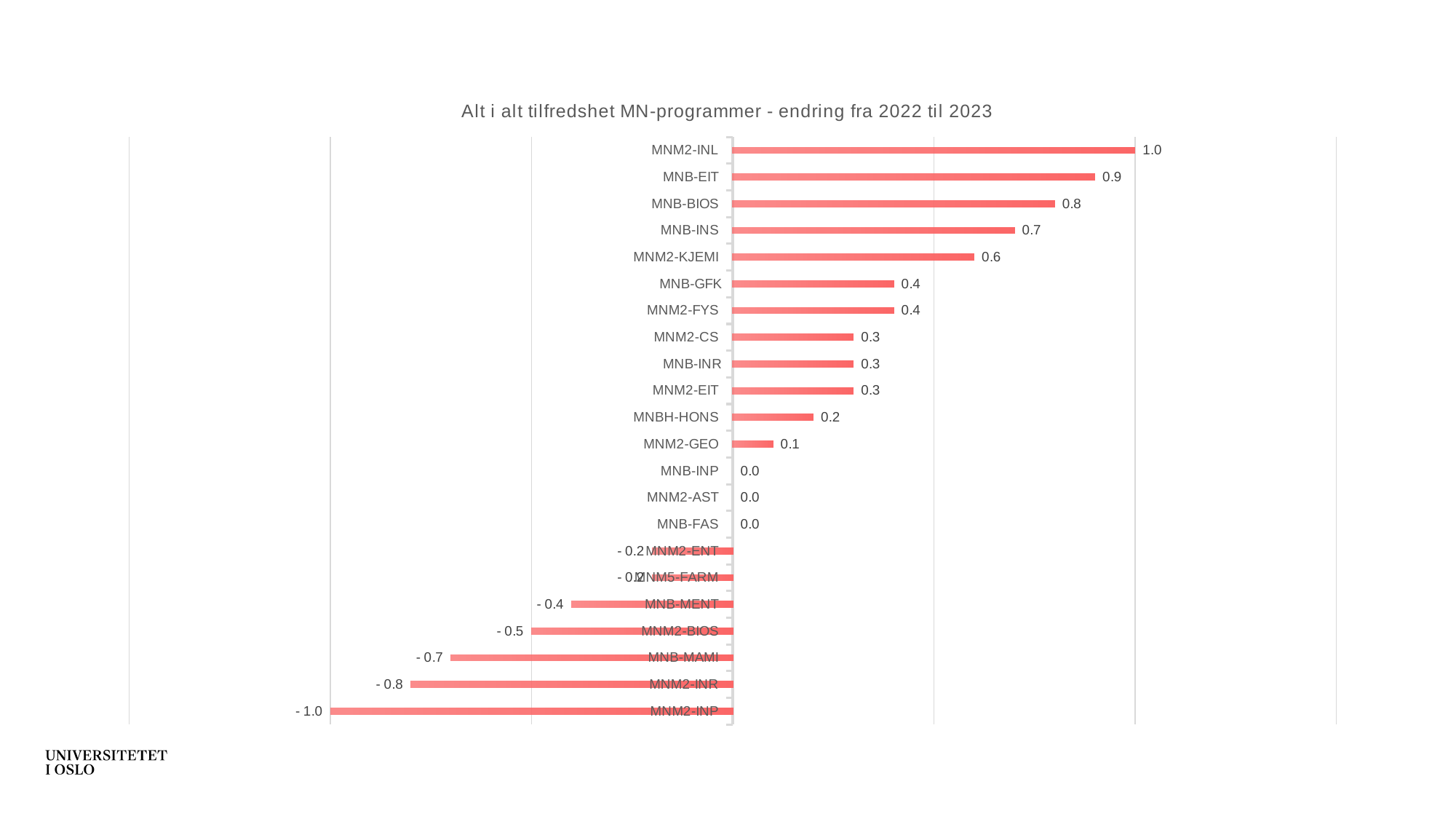
What is the value for MNBH-HONS? 0.2 What is the value for MNM2-INL? 1.0 What is the value for MNB-MAMI? -0.7 Which program has the highest value? MNM2-INL How many programs are shown in the chart? 22 What is the title of the chart? Alt i alt tilfredshet MN-programmer - endring fra 2022 til 2023 What type of chart is shown on the slide? bar chart What is the value for MNB-BIOS? 0.8 What is the difference between the values for MNB-EIT and MNB-INS? 0.2 Which is larger, the value for MNB-GFK or the value for MNM2-GEO? MNB-GFK Which program has the lowest value? MNM2-INP What is the value for MNM2-KJEMI? 0.6